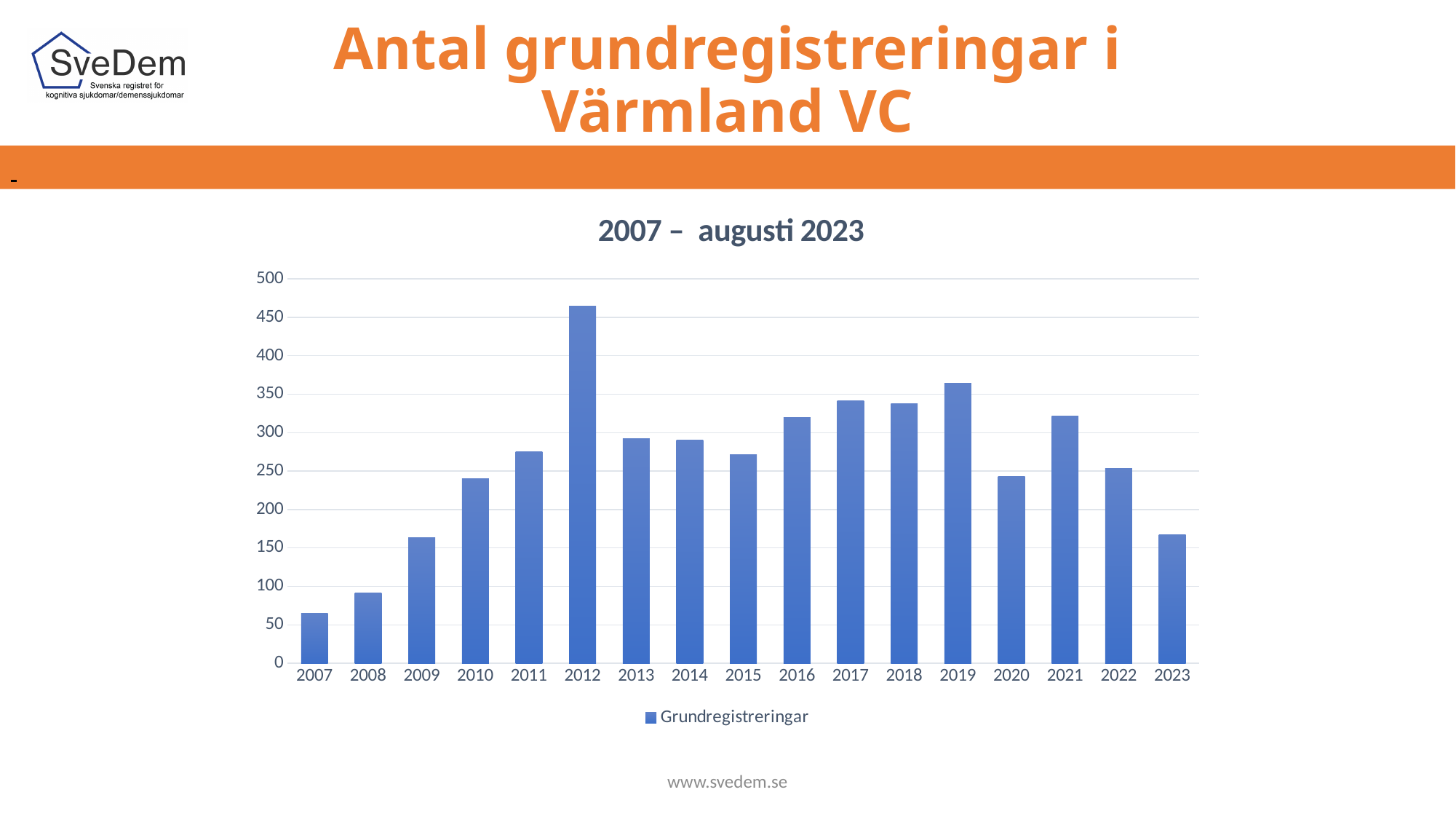
Is the value for 2019 greater or less than 350? greater Do the values rise or fall from 2007 to 2012? rise What is the name of the series shown in the legend? Grundregistreringar What type of chart is shown on the slide? bar chart Which year has the lowest number of grundregistreringar? 2007 Is the value for 2007 greater or less than 100? less Is the value for 2012 greater or less than 450? greater Which year has the highest number of grundregistreringar? 2012 How many years are shown on the x axis? 17 Which year has a higher value, 2009 or 2022? 2022 How many series does the legend list? 1